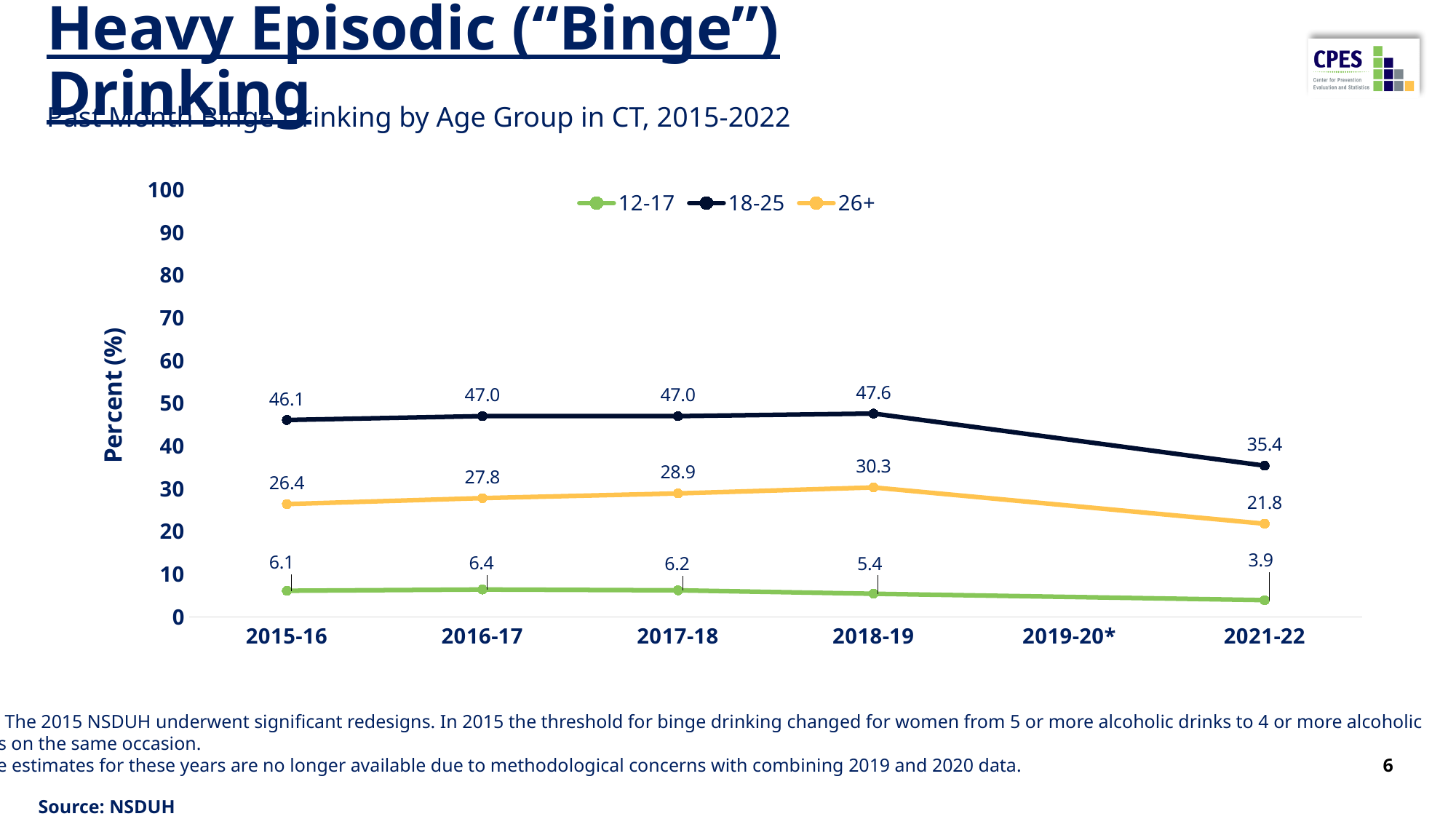
What was the past month binge drinking percentage for the 18-25 age group in 2018-19? 47.6 What was the value for the 26+ age group in 2021-22? 21.8 What kind of chart is shown on the slide? line chart Did the 18-25 series rise or fall between 2018-19 and 2021-22? fall In which period did the 12-17 age group have its lowest value? 2021-22 How many periods are labelled on the x axis? 6 What was the value for the 12-17 age group in 2016-17? 6.4 How many series does the legend list? 3 By how much did the 26+ value change from 2018-19 to 2021-22? 8.5 In which period did the 18-25 age group reach its highest value? 2018-19 What is the difference between the 18-25 value and the 26+ value in 2015-16? 19.7 Which age group had the higher value in 2017-18, 12-17 or 26+? 26+